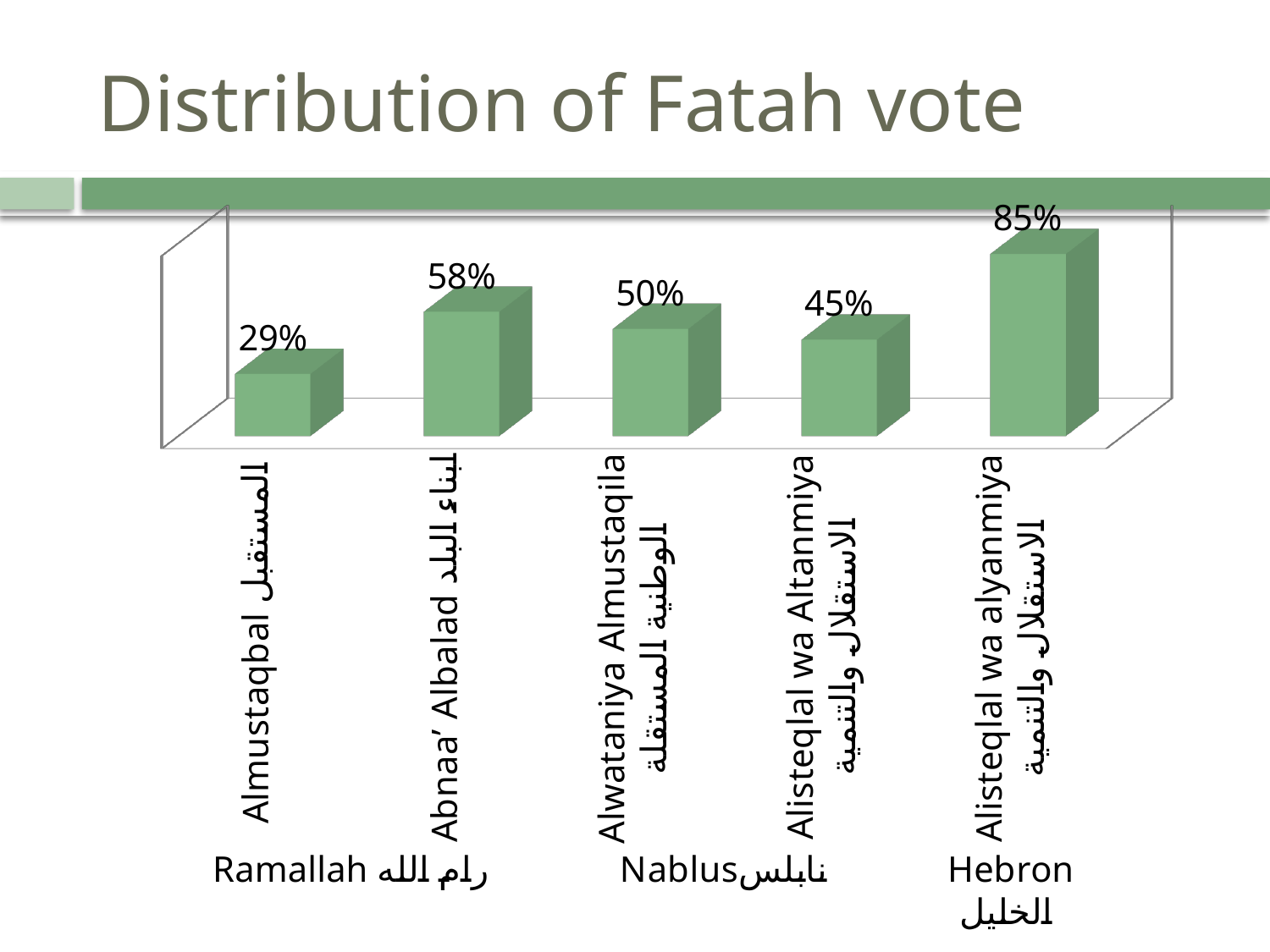
What is the value for Alisteqlal wa Altanmiya? 45% What is the value for Almustaqbal? 29% What is the value for Alisteqlal wa alyanmiya? 85% What is the difference between the values for Alisteqlal wa alyanmiya and Almustaqbal? 56% Which category has the lowest value? Almustaqbal Which is larger, the value for Alwataniya Almustaqila or the value for Alisteqlal wa Altanmiya? Alwataniya Almustaqila Which category has the highest value? Alisteqlal wa alyanmiya How many bars are shown in the chart? 5 What is the title of the chart? Distribution of Fatah vote What is the value for Alwataniya Almustaqila? 50% What is the value for Abnaa' Albalad? 58% What is the difference between the values for Abnaa' Albalad and Alwataniya Almustaqila? 8%